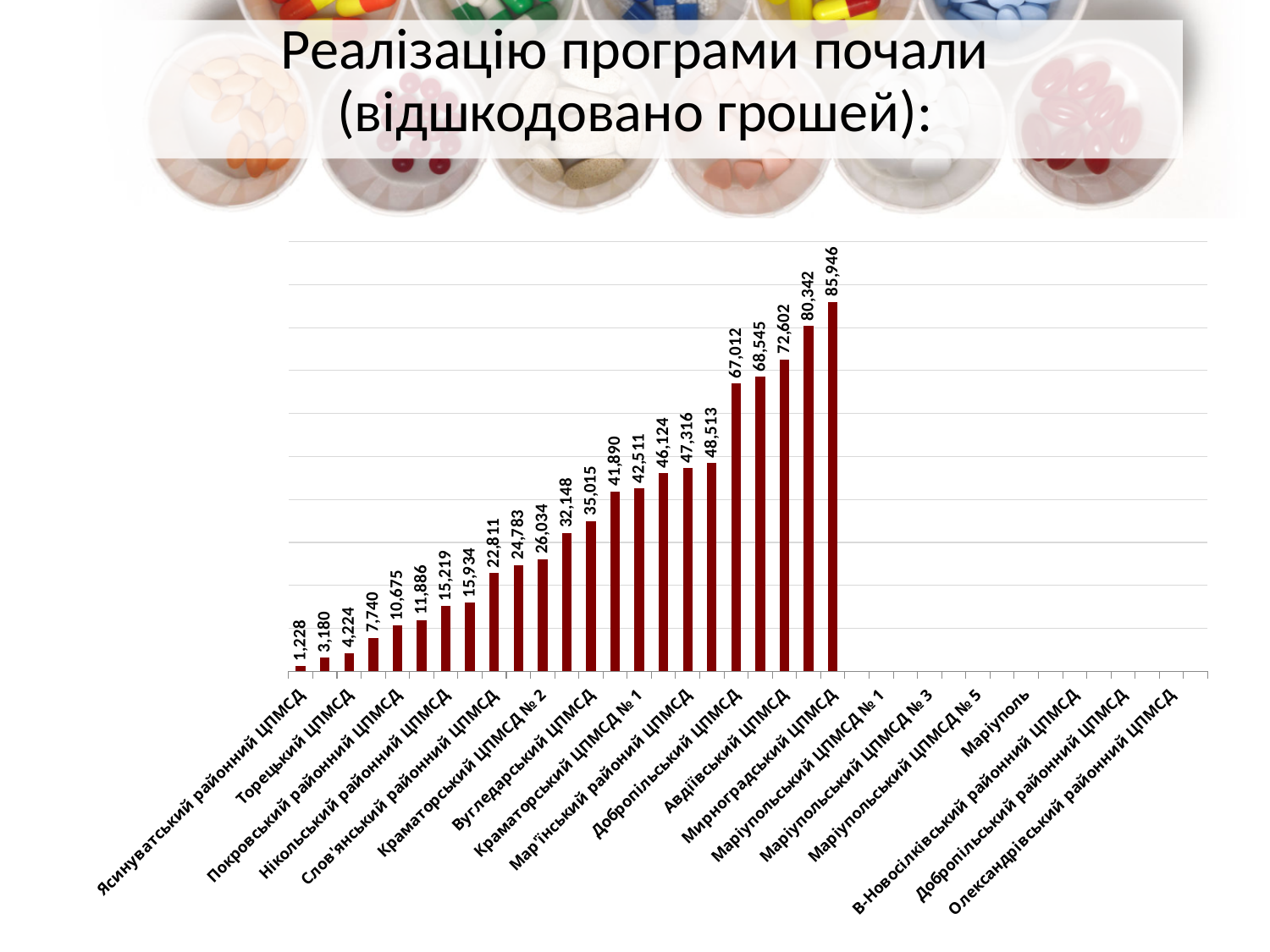
Which is larger, the bar labelled 48,513 or the bar labelled 67,012? 67,012 What is the difference between the two tallest bars, 85,946 and 80,342? 5,604 What is the value shown on the tallest bar in the chart? 85,946 How many bars have a labelled value above 50,000? 5 What is the second-highest value labelled in the chart? 80,342 What is the title of the slide containing the chart? Реалізацію програми почали (відшкодовано грошей): How many bars with data labels are plotted in the chart? 23 Do the bar values rise or fall from left to right along the x axis? rise What kind of chart is shown on the slide? bar chart What is the value shown on the shortest bar in the chart? 1,228 What colour are the bars in the chart? dark red What is the difference between the tallest bar (85,946) and the shortest bar (1,228)? 84,718